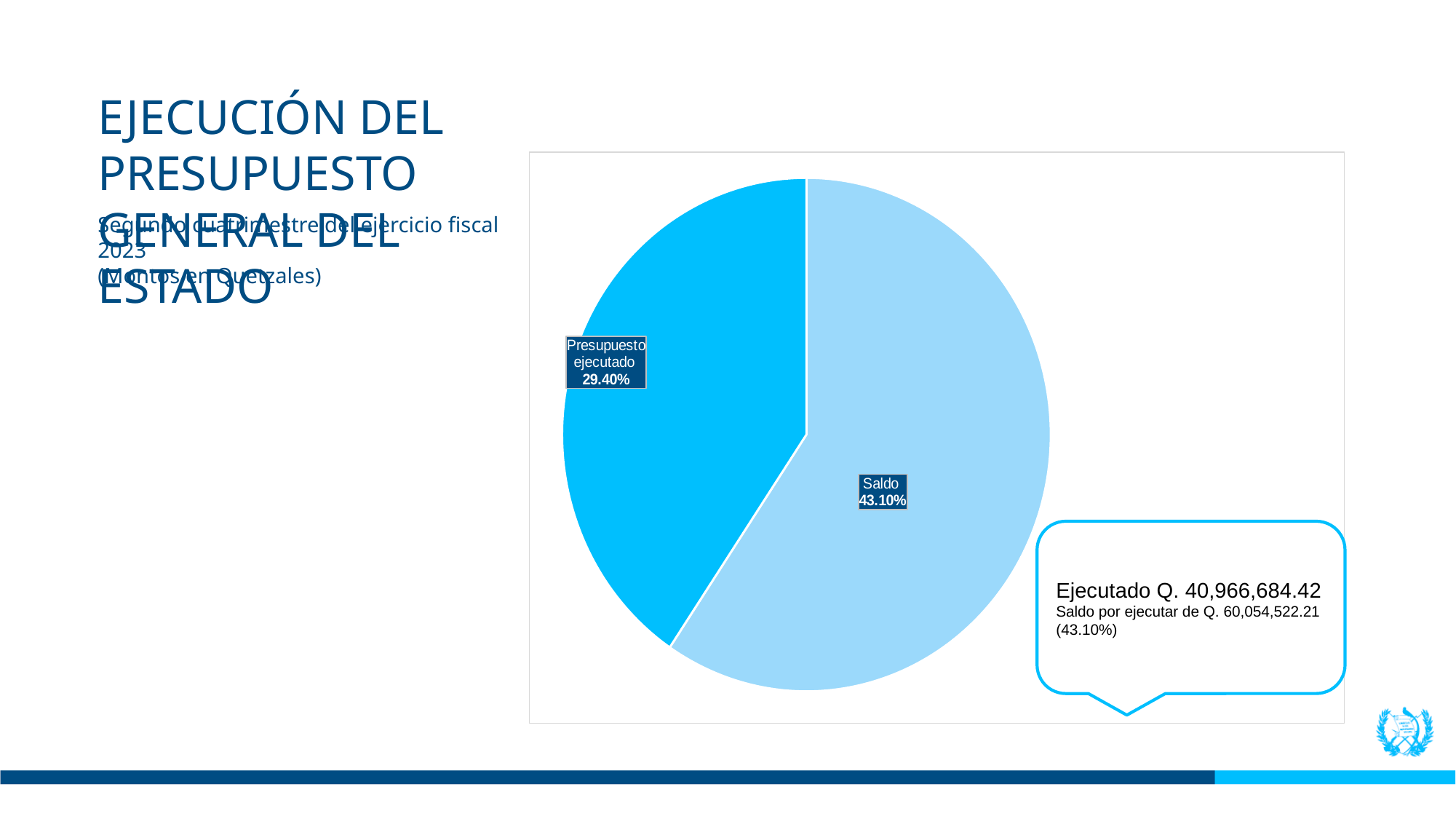
Which slice is drawn in the darker blue colour? Presupuesto ejecutado Which is larger, the 'Saldo' slice or the 'Presupuesto ejecutado' slice? Saldo What kind of chart is shown on the slide? Pie chart What share of the pie is labelled for 'Presupuesto ejecutado'? 29.40% Which slice of the pie chart is the largest? Saldo How many slices does the pie chart have? 2 What percentage is shown for the 'Presupuesto ejecutado' slice? 29.40% What is the difference between the percentages labelled for 'Saldo' and 'Presupuesto ejecutado'? 13.70% What percentage is shown for the 'Saldo' slice? 43.10% Which slice of the pie chart is the smallest? Presupuesto ejecutado According to the callout next to the chart, what is the amount 'Ejecutado'? Q. 40,966,684.42